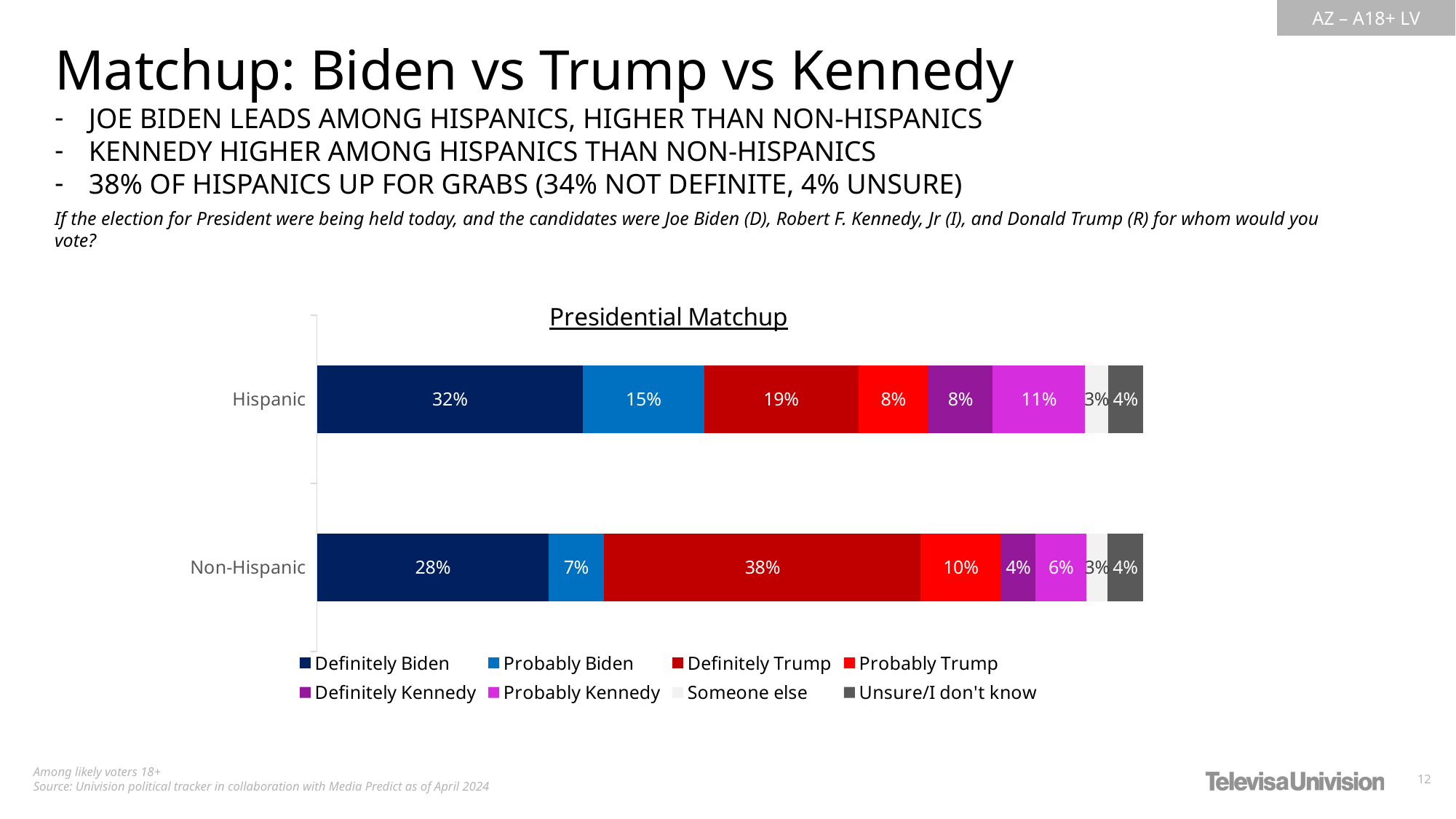
Which segment is the largest in the Hispanic bar? Definitely Biden What kind of chart is shown on the slide? Stacked bar chart What is the difference between Definitely Trump for Non-Hispanic and Definitely Trump for Hispanic voters? 19% Which is larger: Probably Biden among Hispanic voters or Probably Biden among Non-Hispanic voters? Hispanic What is the title of the chart? Presidential Matchup What is the value for Probably Kennedy among Hispanic voters? 11% How many categories are shown on the chart? 2 Which segment is the largest in the Non-Hispanic bar? Definitely Trump What is the value for Probably Biden among Non-Hispanic voters? 7% What is the value for Definitely Trump among Non-Hispanic voters? 38% What is the value for Definitely Biden among Hispanic voters? 32% How many series does the legend list? 8